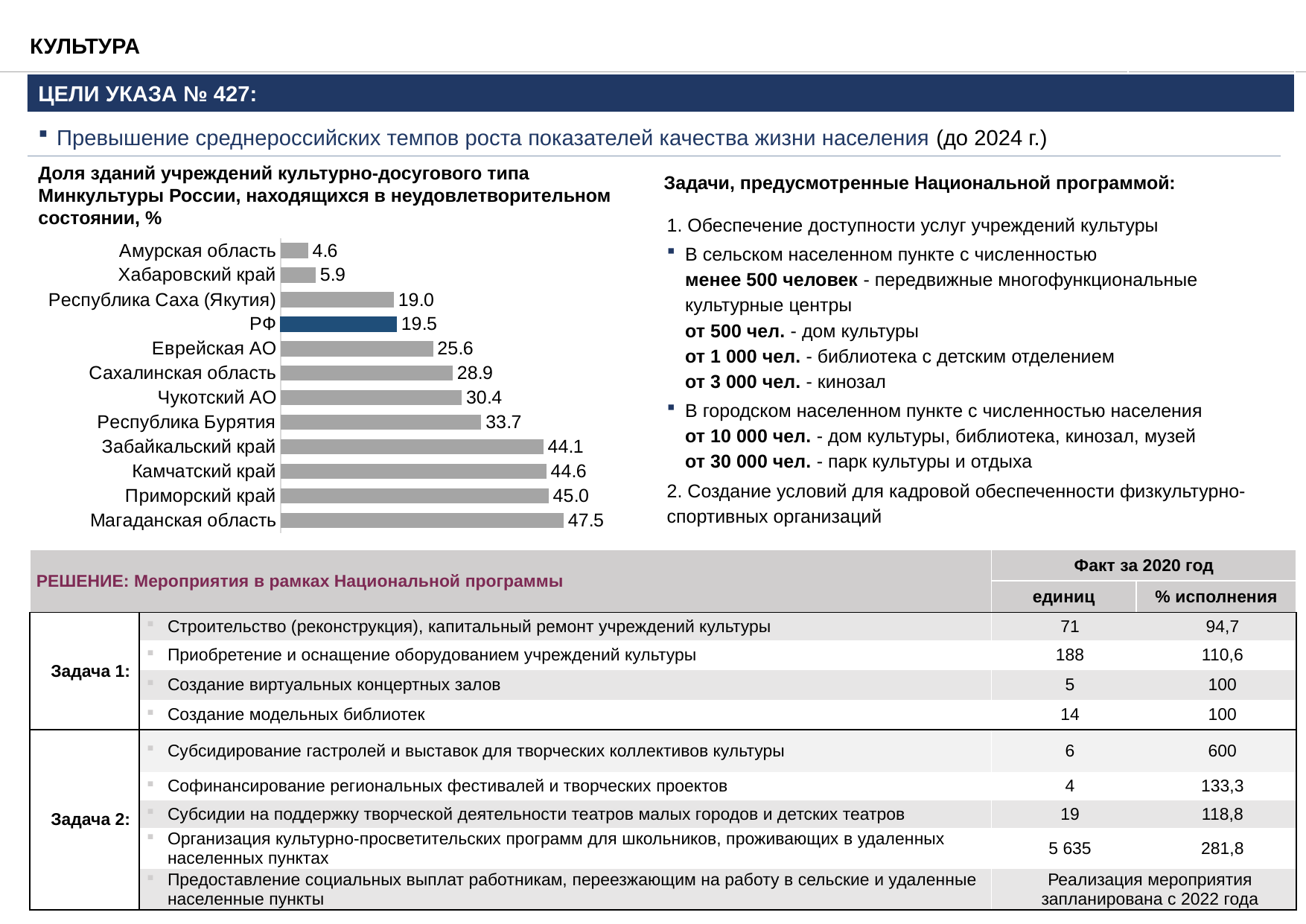
What is the value for Магаданская область in the chart of the share of cultural institution buildings in unsatisfactory condition? 47.5 Which region has the lowest value in the bar chart? Амурская область What type of chart is used to show the share of cultural institution buildings in unsatisfactory condition? Bar chart By how much does the value for Республика Бурятия exceed the value for РФ in the bar chart? 14.2 Which has a larger value in the bar chart, Сахалинская область or Забайкальский край? Забайкальский край How many regions (categories) are shown in the bar chart? 12 What is the difference between the values for Магаданская область and Амурская область in the bar chart? 42.9 Which region has the highest value in the bar chart? Магаданская область Which has a larger value in the bar chart, Хабаровский край or Еврейская АО? Еврейская АО Which bar in the chart is highlighted in dark blue rather than grey? РФ What is the value for Чукотский АО in the bar chart? 30.4 What is the value shown for РФ in the bar chart? 19.5